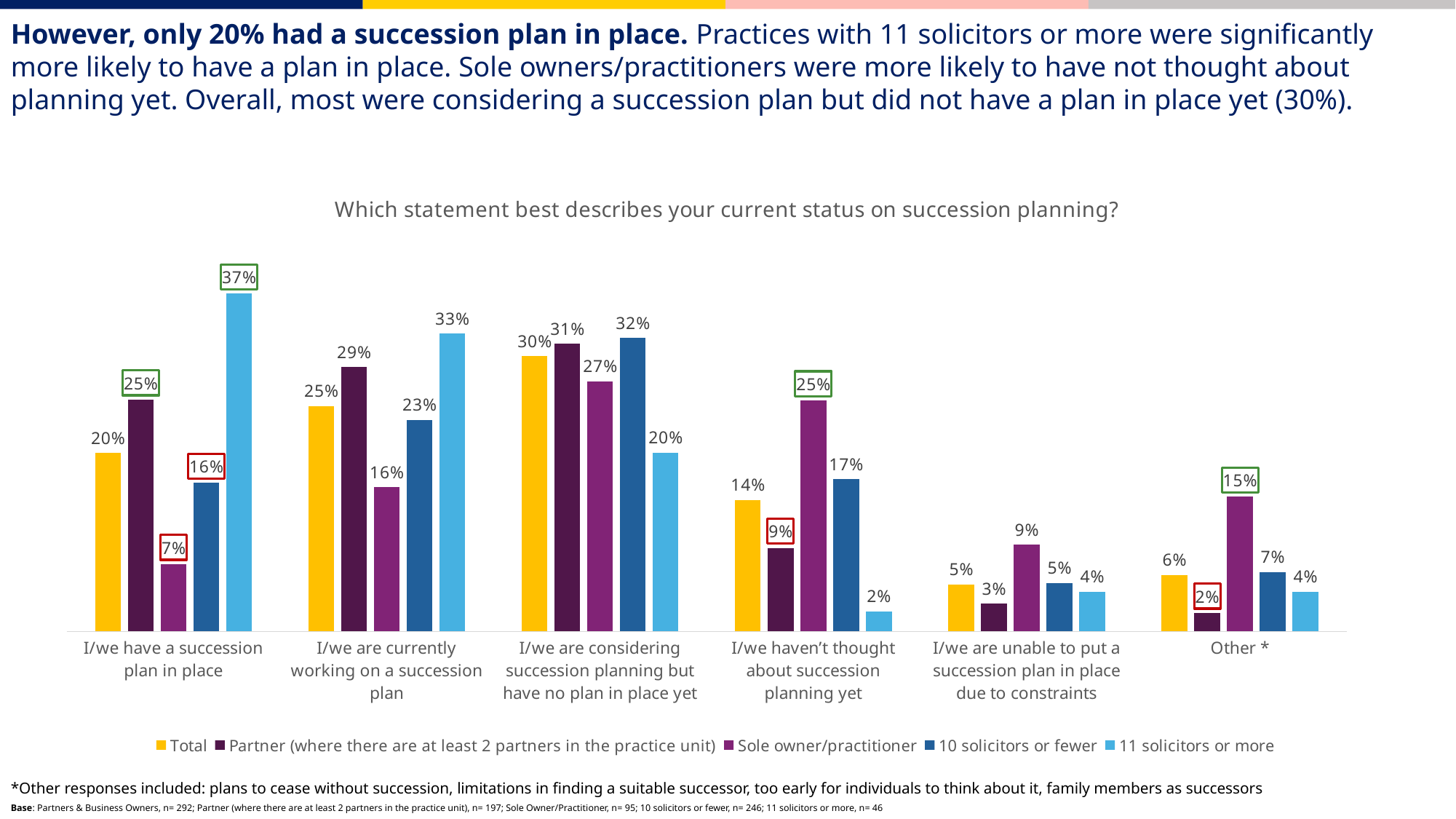
Which category has the highest Total value? I/we are considering succession planning but have no plan in place yet What is the value for '11 solicitors or more' in the 'I/we have a succession plan in place' category? 37% What kind of chart is shown on the slide? Bar chart What is the Total value for 'I/we have a succession plan in place'? 20% What is the title of the chart? Which statement best describes your current status on succession planning? How many response categories are shown on the x axis? 6 What is the difference between the '11 solicitors or more' and 'Sole owner/practitioner' values for 'I/we have a succession plan in place'? 30% How many series does the legend list? 5 Which category has the lowest Total value? I/we are unable to put a succession plan in place due to constraints What is the value for 'Sole owner/practitioner' in the 'I/we haven't thought about succession planning yet' category? 25% What is the value for '11 solicitors or more' in the 'I/we haven't thought about succession planning yet' category? 2% In the 'I/we are currently working on a succession plan' category, which is larger: the Partner value or the '10 solicitors or fewer' value? Partner (where there are at least 2 partners in the practice unit)